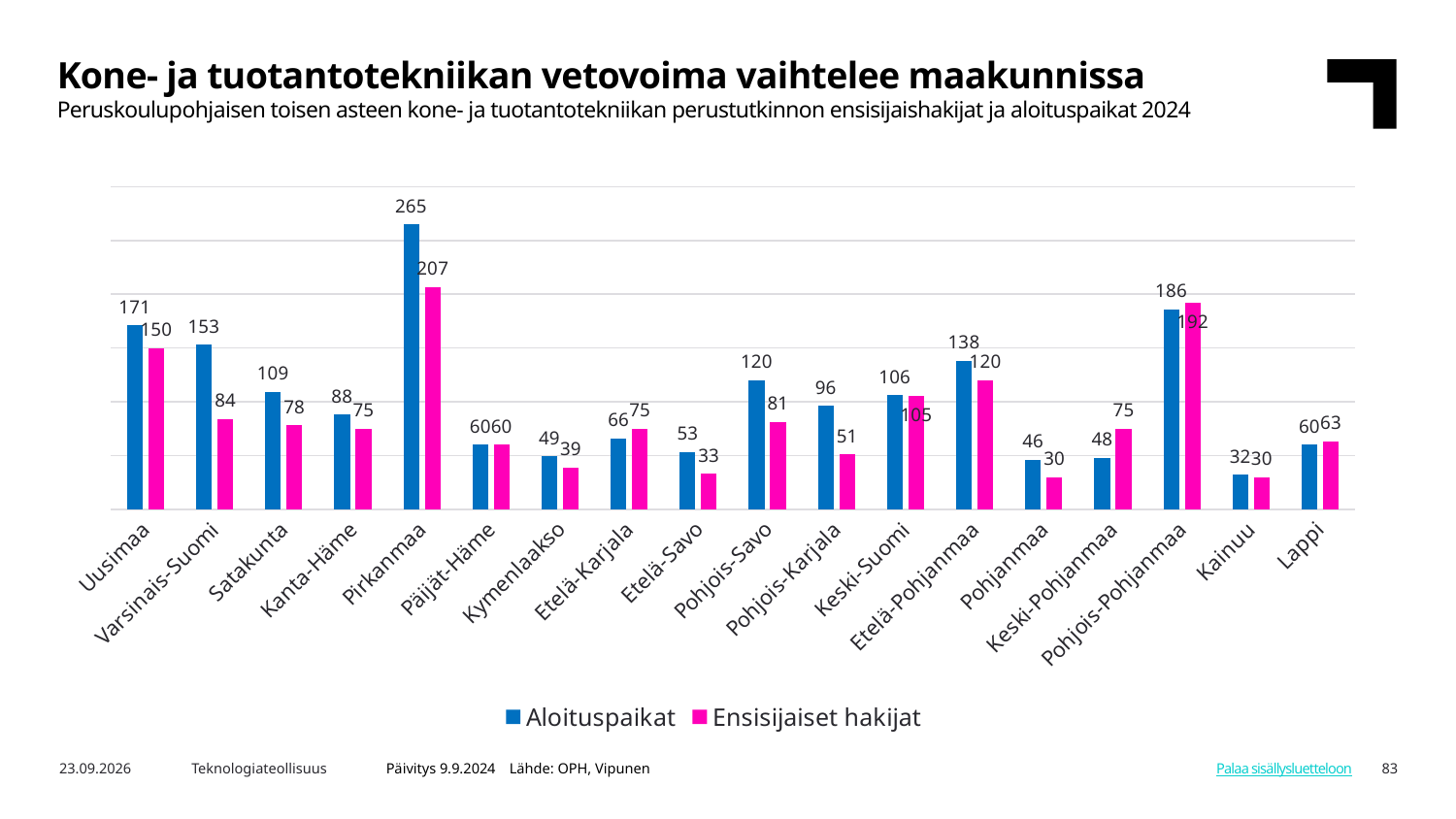
What is the Ensisijaiset hakijat value for Varsinais-Suomi? 84 Which region has the highest Aloituspaikat value? Pirkanmaa Which is larger for Keski-Pohjanmaa, Aloituspaikat or Ensisijaiset hakijat? Ensisijaiset hakijat How many series does the legend list? 2 Which colour represents Ensisijaiset hakijat in the chart? Pink What is the difference between Aloituspaikat and Ensisijaiset hakijat for Pirkanmaa? 58 What is the difference between Aloituspaikat and Ensisijaiset hakijat for Varsinais-Suomi? 69 What is the Ensisijaiset hakijat value for Pohjois-Pohjanmaa? 192 What is the Aloituspaikat value for Pirkanmaa? 265 How many regions are shown on the x axis? 18 What kind of chart is shown on the slide? Bar chart Which region has the lowest Ensisijaiset hakijat value? Pohjanmaa and Kainuu (both 30)